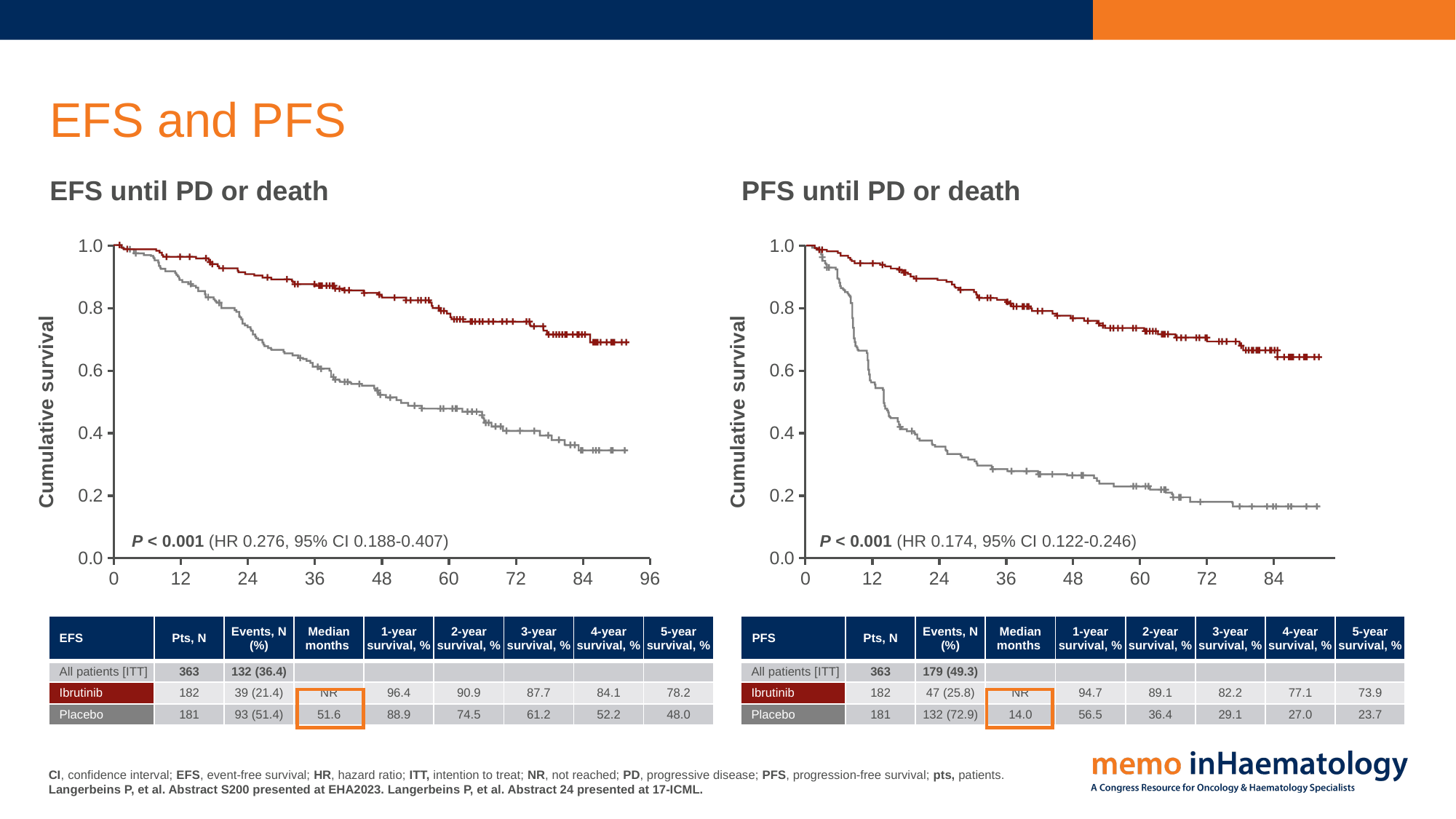
In the EFS table, what is the median months value for placebo? 51.6 In the 'PFS until PD or death' chart, which curve is higher at 36 months, the red (ibrutinib) or the grey (placebo)? red (ibrutinib) What hazard ratio is printed on the 'EFS until PD or death' chart? 0.276 In the PFS table, what is the Events, N (%) value for placebo? 132 (72.9) What kind of chart is the 'EFS until PD or death' chart? line chart In the 'PFS until PD or death' chart, do the survival curves rise or fall along the x axis? fall In the EFS table, what is the difference in 1-year survival % between ibrutinib (96.4) and placebo (88.9)? 7.5 In the 'PFS until PD or death' chart, is the red (ibrutinib) curve at 24 months greater or less than 0.8? greater What 95% CI is printed on the 'PFS until PD or death' chart? 0.122-0.246 In the 'EFS until PD or death' chart, is the grey (placebo) curve at 84 months greater or less than 0.4? less In the 'EFS until PD or death' chart, is the grey (placebo) curve at 48 months greater or less than 0.6? less In the PFS table, what is the 5-year survival % for ibrutinib? 73.9